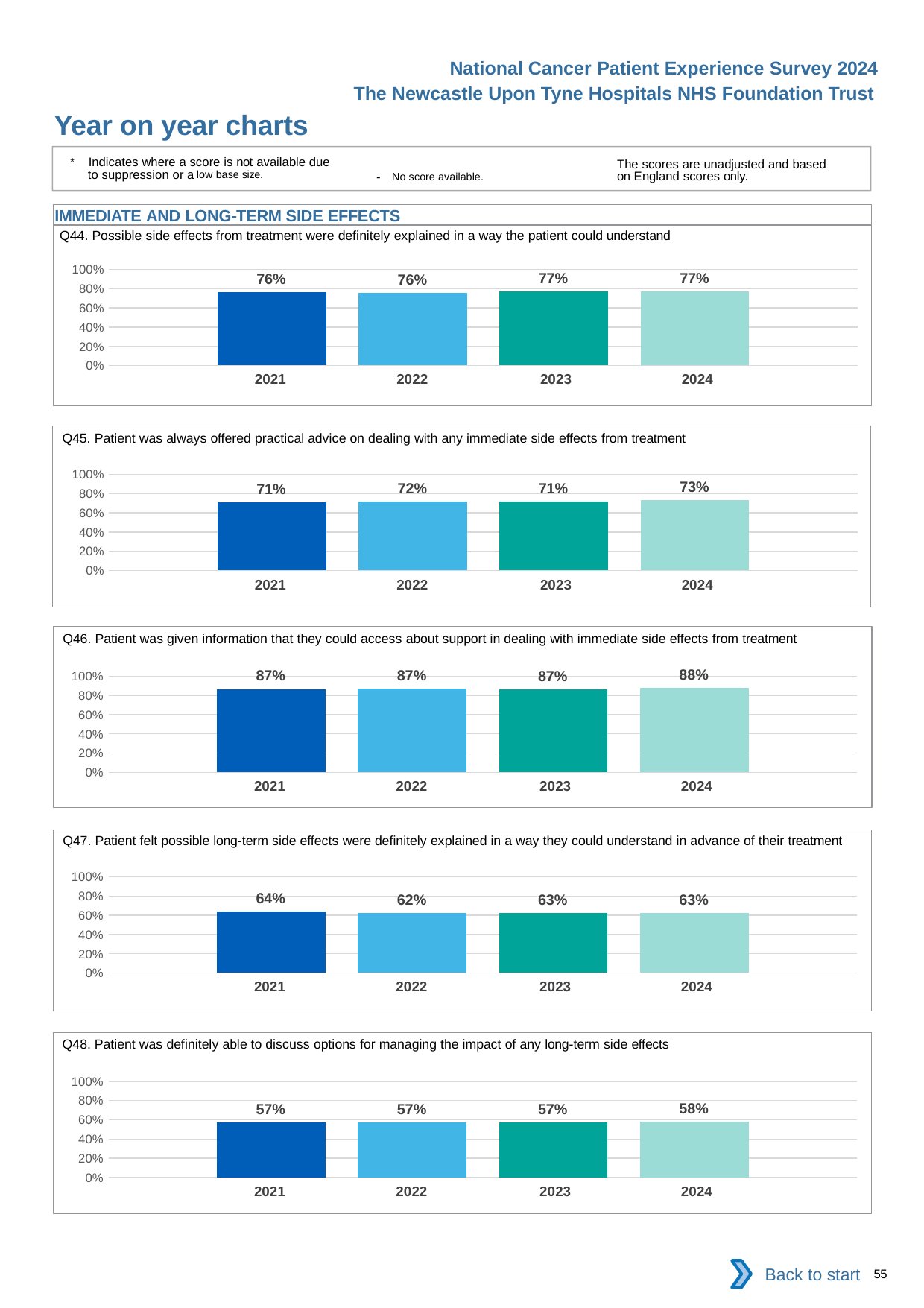
In the Q45 chart, which year has the highest value? 2024 In the Q44 chart, what is the difference between the 2023 value and the 2022 value? 1% In the Q45 chart, what is the difference between the 2024 value and the 2021 value? 2% In the Q46 chart, how many years are plotted? 4 What kind of chart is the Q44 chart? Bar chart In the Q47 chart, what is the value for 2021? 64% In the Q47 chart, is the value for 2021 greater or less than 60%? greater In the Q48 chart, which is larger, the value for 2023 or the value for 2024? 2024 In the Q46 chart, what is the value for 2023? 87% In the Q48 chart, what is the value for 2022? 57% In the Q44 chart, what is the value for 2024? 77% In the Q47 chart, which year has the lowest value? 2022